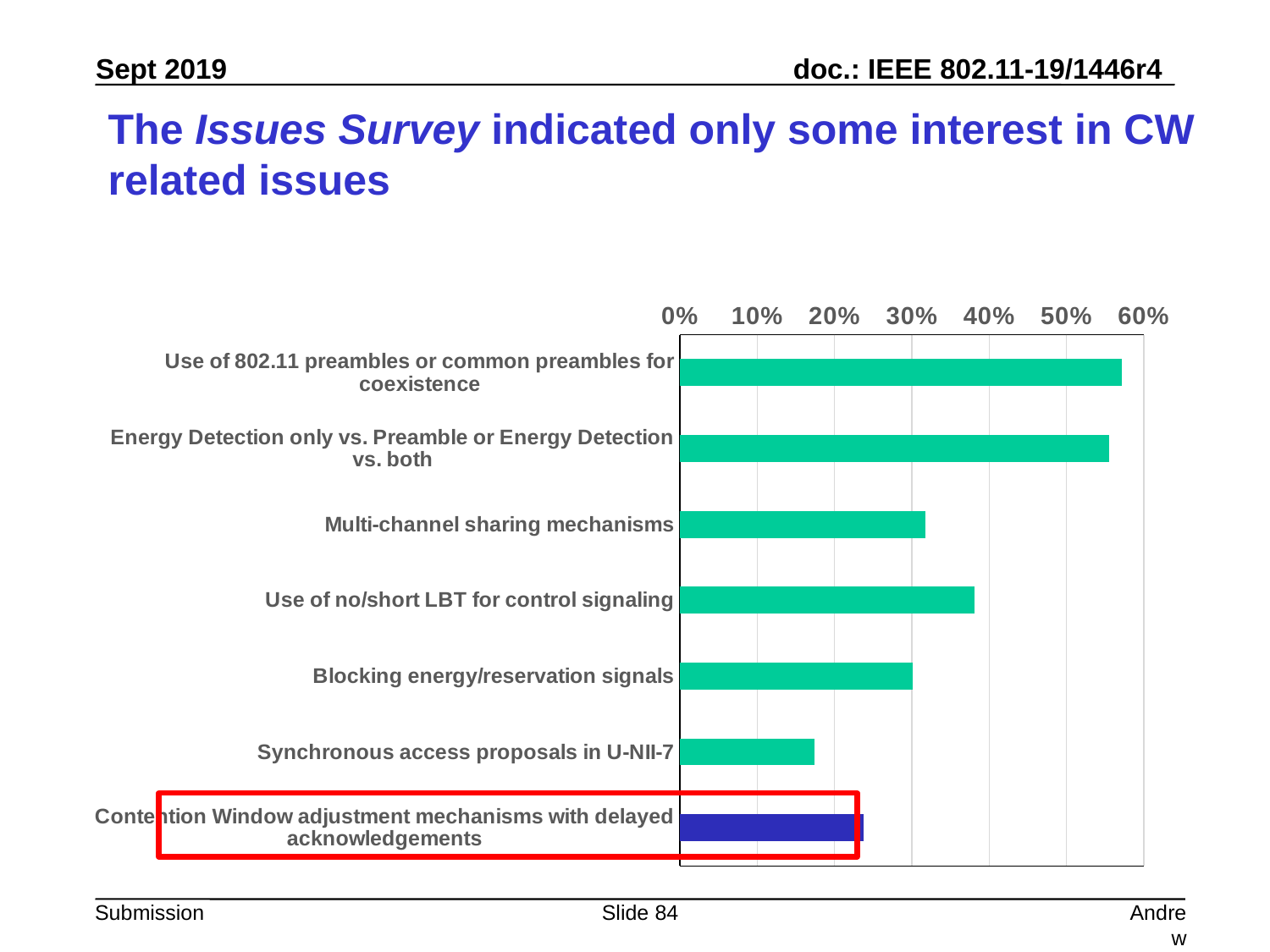
What kind of chart is shown on the slide? bar chart Is the value for 'Use of no/short LBT for control signaling' greater or less than 30%? greater Which has the larger value: 'Blocking energy/reservation signals' or 'Synchronous access proposals in U-NII-7'? Blocking energy/reservation signals Is the value for 'Synchronous access proposals in U-NII-7' greater or less than 20%? less Is the value for 'Energy Detection only vs. Preamble or Energy Detection vs. both' greater or less than 50%? greater Which has the larger value: 'Use of no/short LBT for control signaling' or 'Multi-channel sharing mechanisms'? Use of no/short LBT for control signaling How many categories (bars) does the chart show? 7 Which category's bar is drawn in a different colour (dark blue) and outlined with a red box? Contention Window adjustment mechanisms with delayed acknowledgements Which category has the lowest value in the chart? Synchronous access proposals in U-NII-7